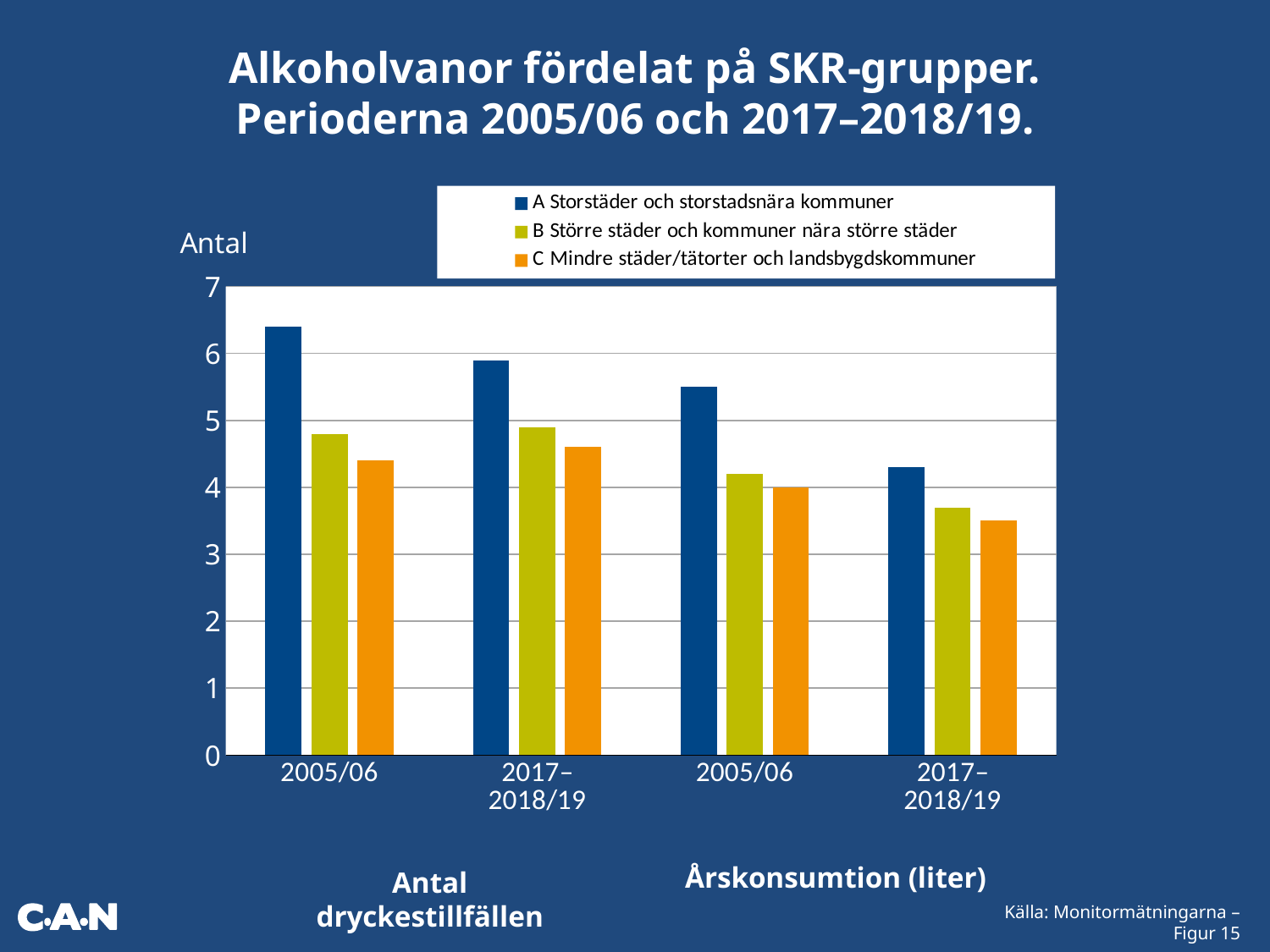
In the Årskonsumtion (liter) section, is the value for B Större städer och kommuner nära större städer in 2005/06 greater or less than 5? less In the Antal dryckestillfällen section, is the value for A Storstäder och storstadsnära kommuner larger in 2005/06 or in 2017–2018/19? 2005/06 What is the label on the y axis? Antal What kind of chart is shown on the slide? Bar chart In the Årskonsumtion (liter) section, which series has the lowest bar for 2017–2018/19? C Mindre städer/tätorter och landsbygdskommuner What colour represents A Storstäder och storstadsnära kommuner in the legend? Dark blue How many series does the legend list? 3 In the Antal dryckestillfällen section, is the value for A Storstäder och storstadsnära kommuner in 2005/06 greater or less than 6? greater In the Årskonsumtion (liter) section, does the value for A Storstäder och storstadsnära kommuner rise or fall from 2005/06 to 2017–2018/19? Fall How many category groups are shown along the x axis? 4 In the Årskonsumtion (liter) section, is the value for C Mindre städer/tätorter och landsbygdskommuner in 2017–2018/19 greater or less than 4? less In the Antal dryckestillfällen section, which series has the highest bar for 2005/06? A Storstäder och storstadsnära kommuner